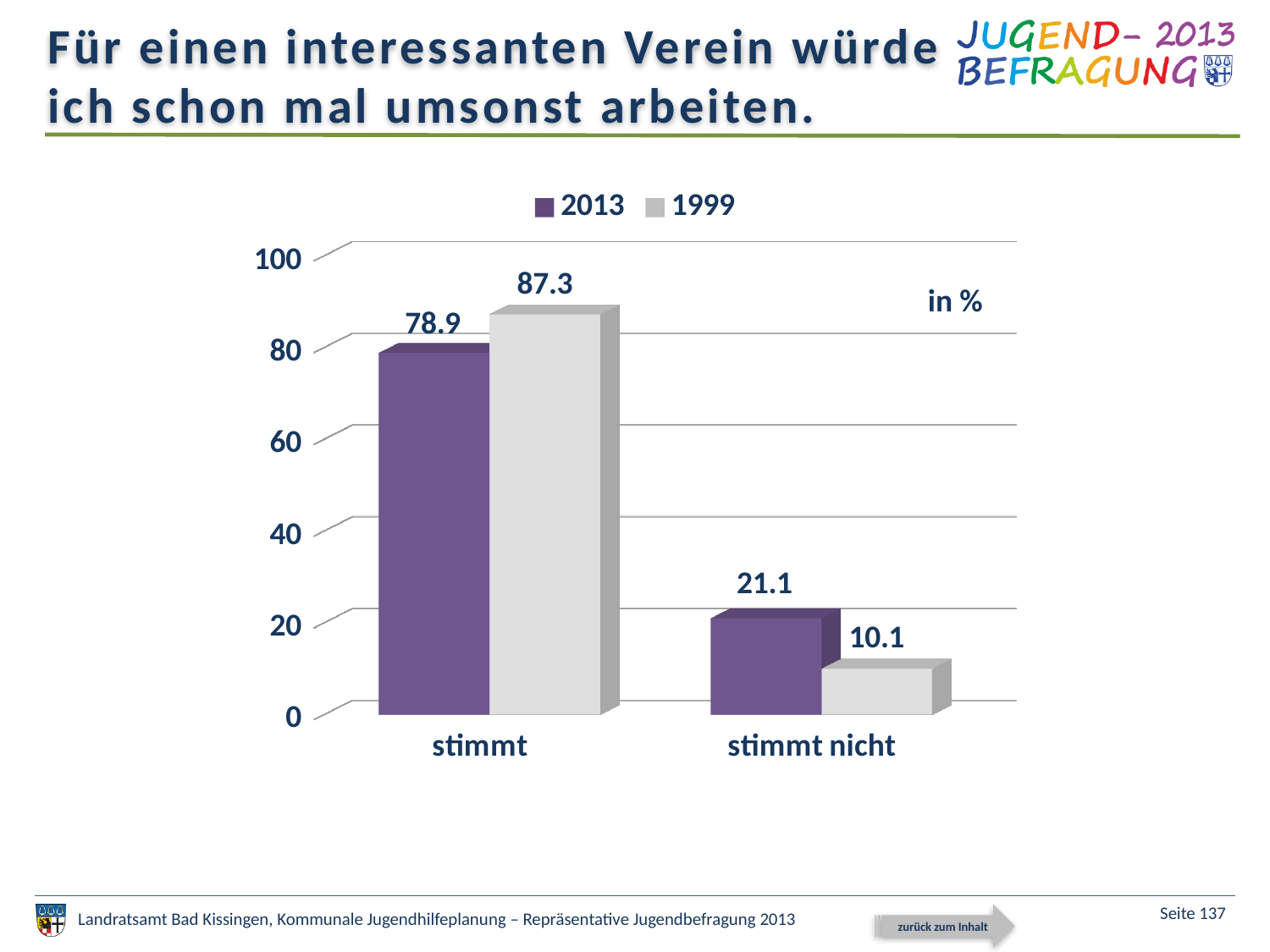
What kind of chart is shown on the slide? bar chart What is the difference between the 1999 and 2013 values for "stimmt"? 8.4 What is the value for "stimmt" in the 2013 series? 78.9 What is the value for "stimmt" in the 1999 series? 87.3 Which series has the higher value for "stimmt", 2013 or 1999? 1999 How many series does the legend list? 2 What is the value for "stimmt nicht" in the 2013 series? 21.1 Which series has the higher value for "stimmt nicht", 2013 or 1999? 2013 Which colour represents the 2013 series in the legend? purple What is the difference between the 2013 and 1999 values for "stimmt nicht"? 11.0 How many categories are shown on the x axis? 2 What is the value for "stimmt nicht" in the 1999 series? 10.1